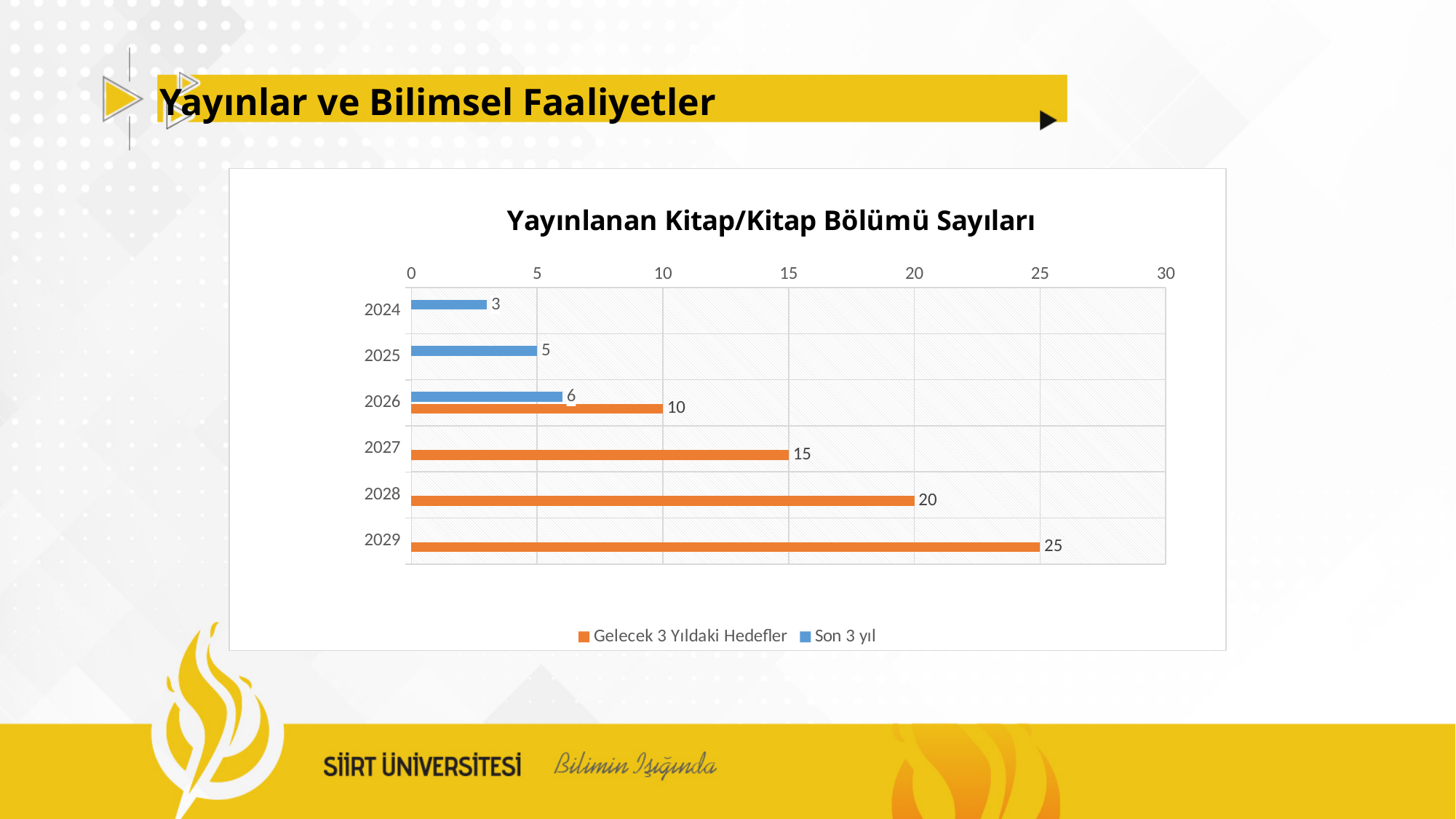
What is the title of the chart? Yayınlanan Kitap/Kitap Bölümü Sayıları For 2026, which series has the larger value: "Son 3 yıl" or "Gelecek 3 Yıldaki Hedefler"? Gelecek 3 Yıldaki Hedefler How many years are shown on the chart? 6 What is the value for 2026 in the "Gelecek 3 Yıldaki Hedefler" series? 10 What is the difference between the 2029 and 2027 values in the "Gelecek 3 Yıldaki Hedefler" series? 10 Is the value for 2029 in the "Gelecek 3 Yıldaki Hedefler" series greater or less than 20? greater What is the value for 2024 in the "Son 3 yıl" series? 3 What kind of chart is shown on the slide? Bar chart How many series does the legend list? 2 Which year has the highest value in the "Gelecek 3 Yıldaki Hedefler" series? 2029 Which year has the lowest value in the "Son 3 yıl" series? 2024 What is the value for 2028 in the "Gelecek 3 Yıldaki Hedefler" series? 20